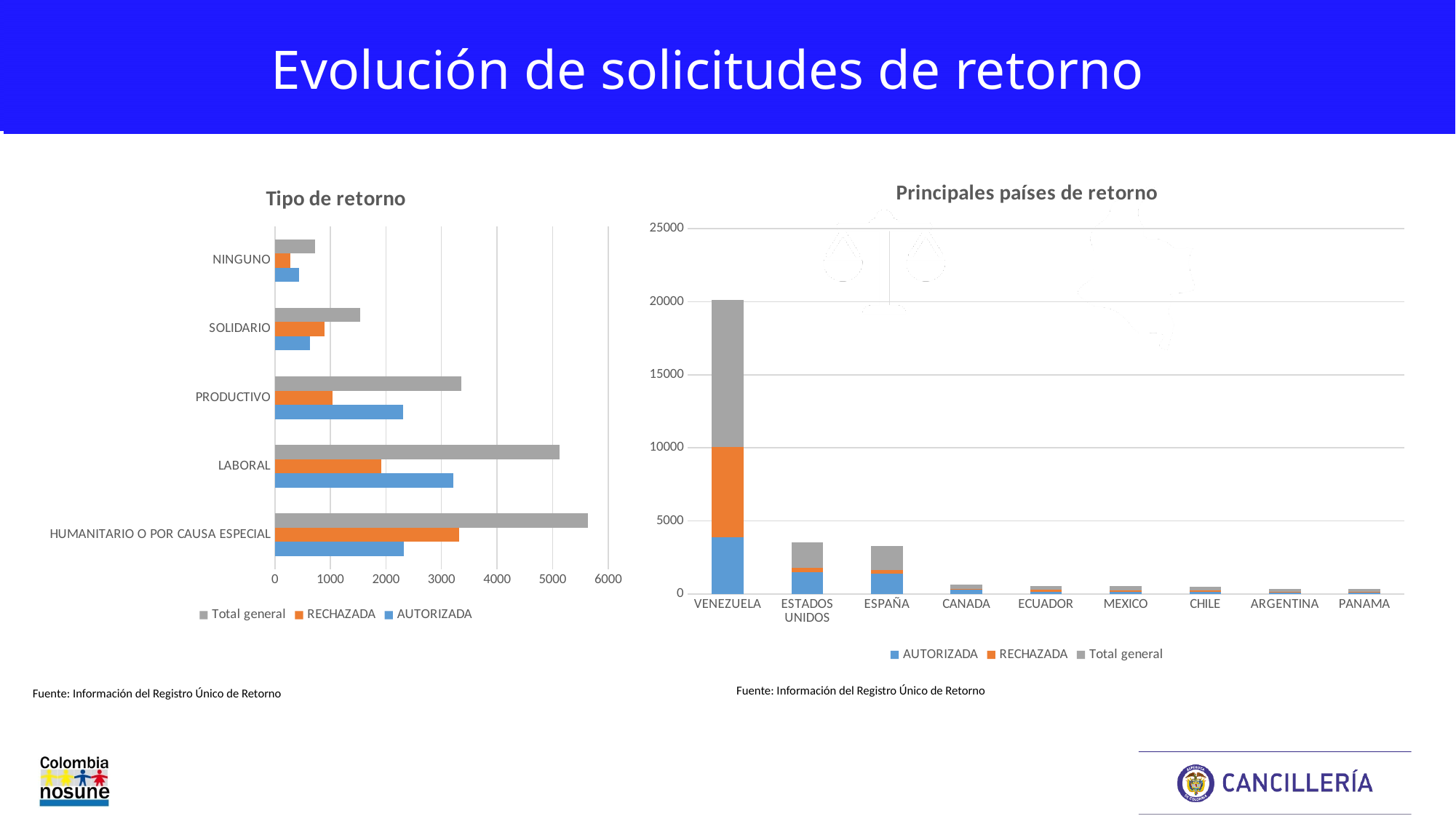
On the 'Tipo de retorno' chart, which category has the highest Total general value? HUMANITARIO O POR CAUSA ESPECIAL On the 'Tipo de retorno' chart, is the AUTORIZADA value for NINGUNO greater or less than 1000? less On the 'Tipo de retorno' chart, is the Total general value for PRODUCTIVO greater or less than 3000? greater How many categories are shown on the 'Tipo de retorno' chart? 5 On the 'Tipo de retorno' chart, which category has the lowest Total general value? NINGUNO On the 'Principales países de retorno' chart, do the stacked bar heights generally rise or fall from left to right? fall How many series does the legend of the 'Tipo de retorno' chart list? 3 On the 'Principales países de retorno' chart, is the top of the stacked bar for ESTADOS UNIDOS greater or less than 5000? less How many countries are shown on the 'Principales países de retorno' chart? 9 What kind of chart is the 'Tipo de retorno' chart? bar chart On the 'Principales países de retorno' chart, which country has the tallest stacked bar? VENEZUELA On the 'Tipo de retorno' chart, which is larger for LABORAL: AUTORIZADA or RECHAZADA? AUTORIZADA